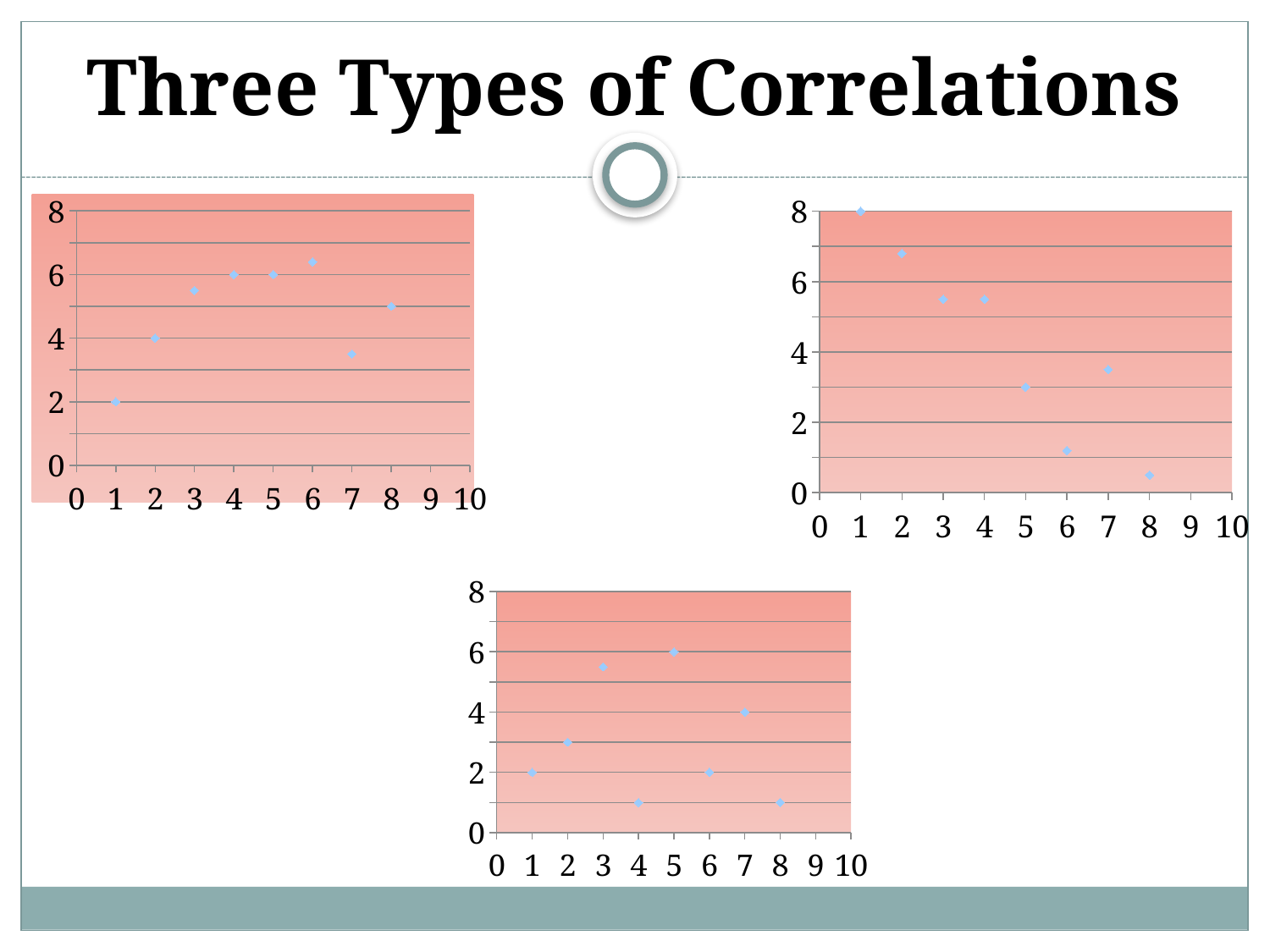
In the top-left chart, at which x value is the lowest point? 1 In the top-right chart, at which x value is the highest point? 1 In the top-left chart, what is the y value of the point at x = 2? 4 What kind of chart is the top-left chart? scatter chart In the top-right chart, what is the y value of the point at x = 1? 8 In the top-left chart, what is the y value of the point at x = 1? 2 How many data points are plotted in the top-right chart? 8 In the top-right chart, do the y values generally rise or fall as x increases? fall In the top-left chart, is the y value of the point at x = 6 greater or less than 6? greater In the top-right chart, is the y value of the point at x = 8 greater or less than 2? less In the bottom chart, what is the y value of the point at x = 5? 6 In the bottom chart, which point has the larger y value: the one at x = 2 or the one at x = 4? x = 2